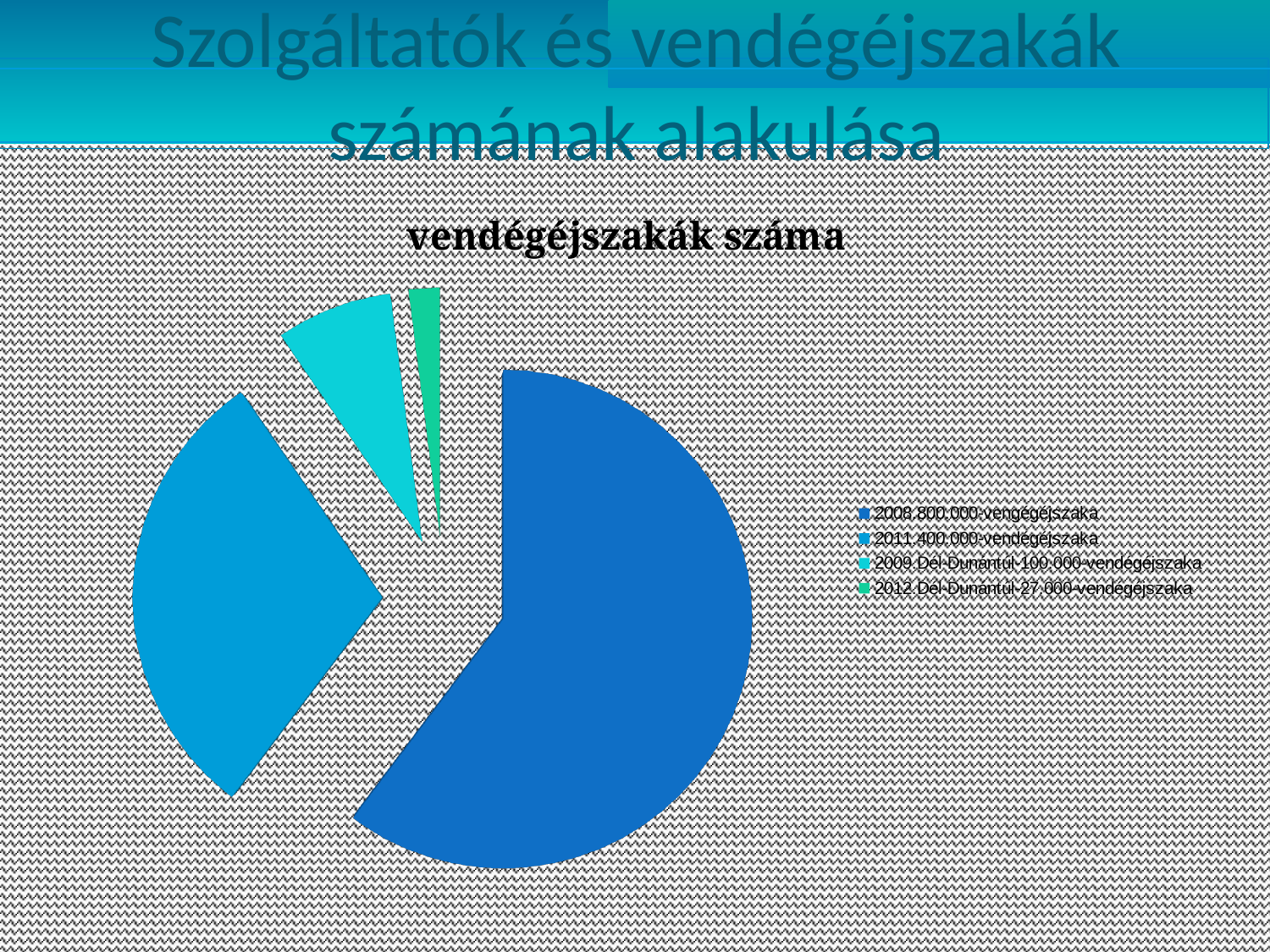
How many slices does the pie chart have? 4 Which slice is larger: the 2009 Dél-Dunántúl slice or the 2012 Dél-Dunántúl slice? 2009 Dél-Dunántúl Which slice is larger: the one for 2008 or the one for 2011? 2008 What is the title of the chart? vendégéjszakák száma What kind of chart is shown on the slide? pie chart According to the legend, how many vendégéjszaka are given for 2009 Dél-Dunántúl? 100.000 What is the difference between the 2008 value and the 2011 value given in the legend? 400.000 Which legend entry corresponds to the smallest slice of the pie? 2012.Dél-Dunántúl-27.000-vendégéjszaka According to the legend, how many vendégéjszaka are given for 2011? 400.000 Which legend entry corresponds to the largest slice of the pie? 2008.800.000-vengégéjszaka What colour is the slice for 2012 Dél-Dunántúl? green How many entries does the legend list? 4